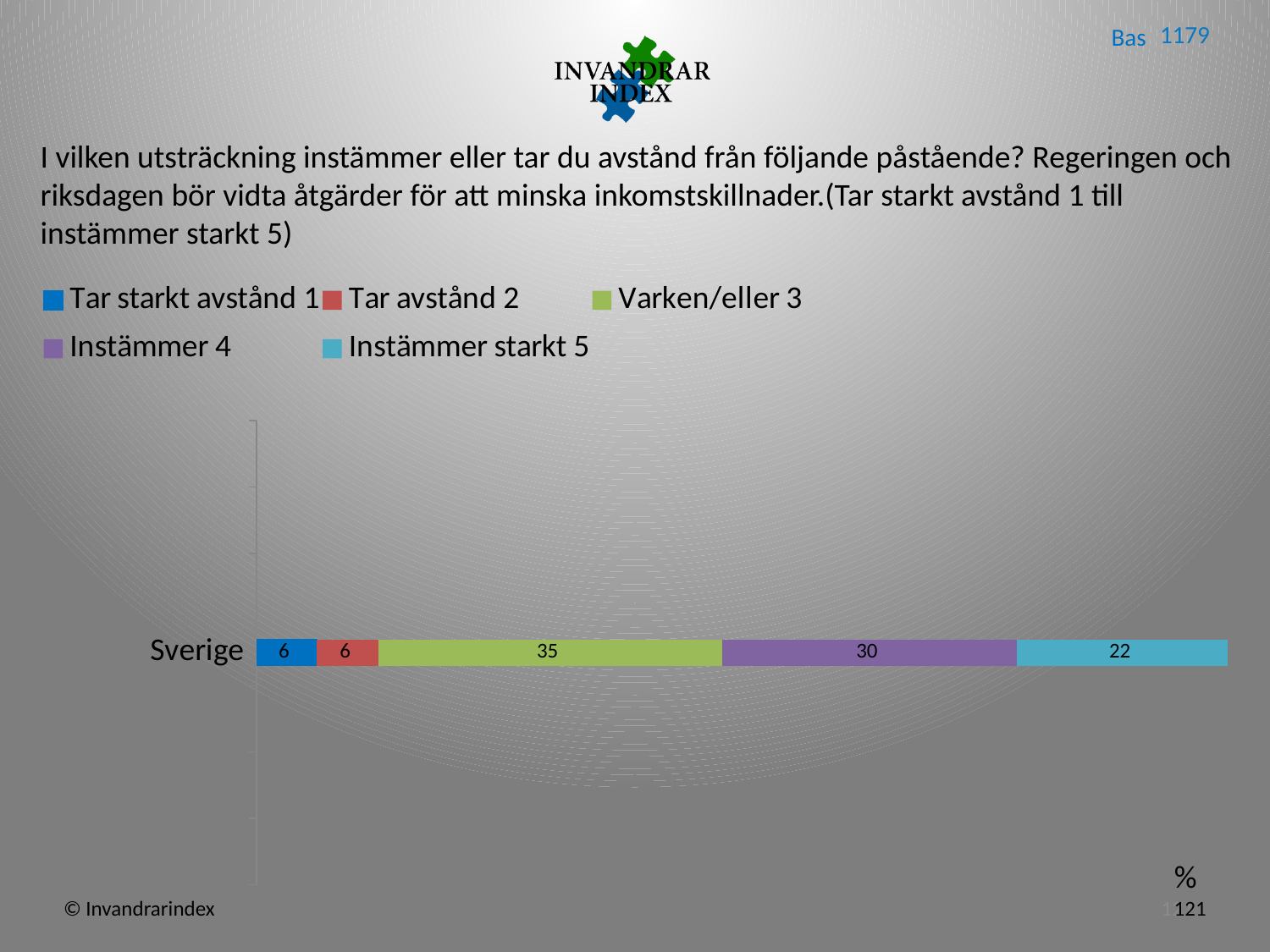
How many categories are plotted on the chart? 1 What is the value for "Instämmer 4" for Sverige? 30 Which series has the highest value for Sverige? Varken/eller 3 Which is larger for Sverige, "Instämmer starkt 5" or "Tar avstånd 2"? Instämmer starkt 5 What is the value for "Tar starkt avstånd 1" for Sverige? 6 What kind of chart is shown on the slide? Stacked bar chart What is the total of the stacked bar for Sverige? 99 How many series does the legend list? 5 What is the value for "Instämmer starkt 5" for Sverige? 22 What is the difference between the values for "Instämmer 4" and "Instämmer starkt 5" for Sverige? 8 What is the value for "Varken/eller 3" for Sverige? 35 What is the difference between the values for "Varken/eller 3" and "Instämmer 4" for Sverige? 5